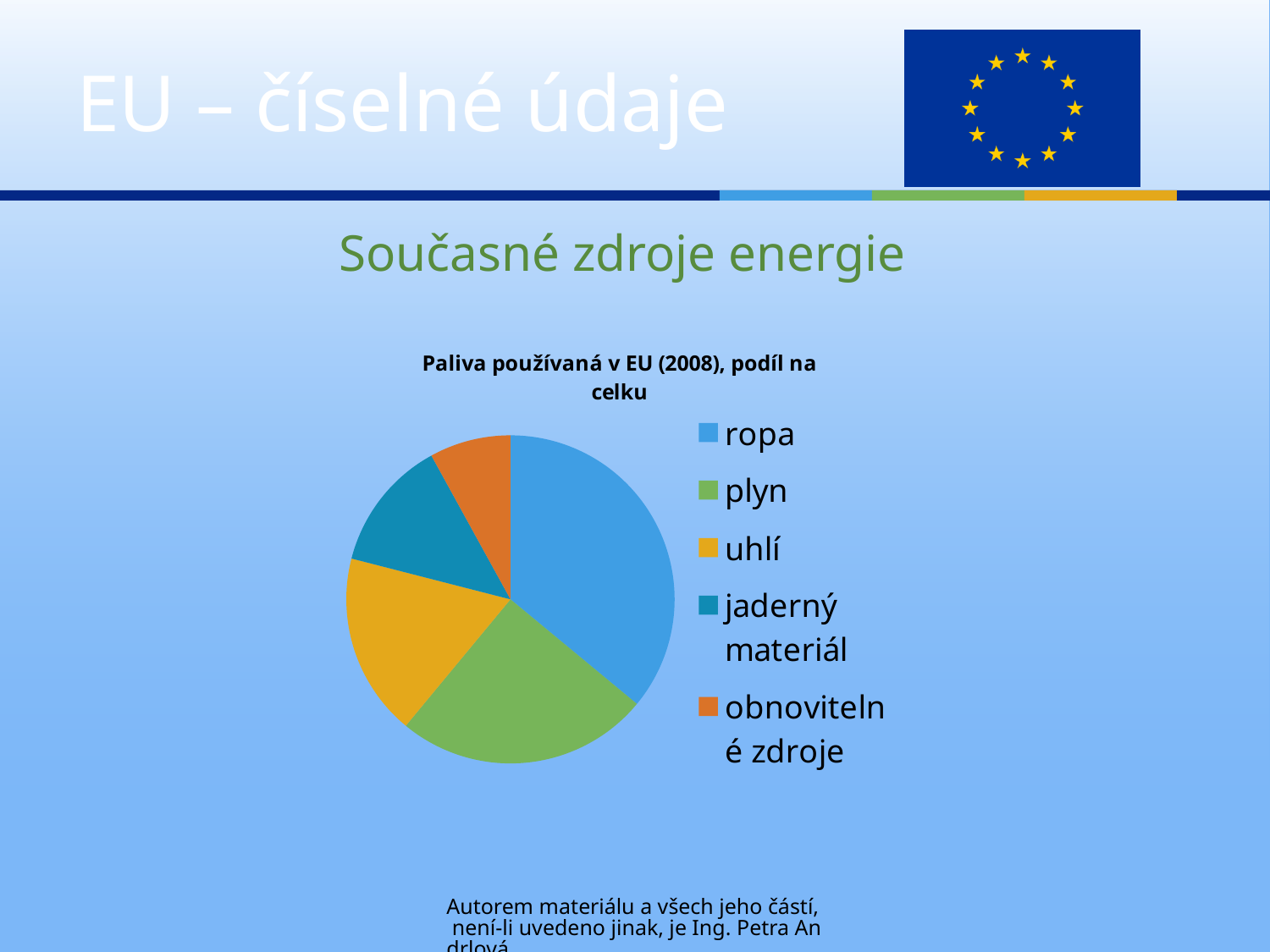
Which slice is larger, ropa or plyn? ropa What is the title of the chart? Paliva používaná v EU (2008), podíl na celku Which slice is larger, jaderný materiál or obnovitelné zdroje? jaderný materiál What colour is the slice for ropa? blue What kind of chart is shown on the slide? pie chart How many categories does the pie chart show? 5 How many entries does the legend list? 5 Which slice is larger, uhlí or obnovitelné zdroje? uhlí Which category has the smallest slice of the pie? obnovitelné zdroje Which category has the largest slice of the pie? ropa